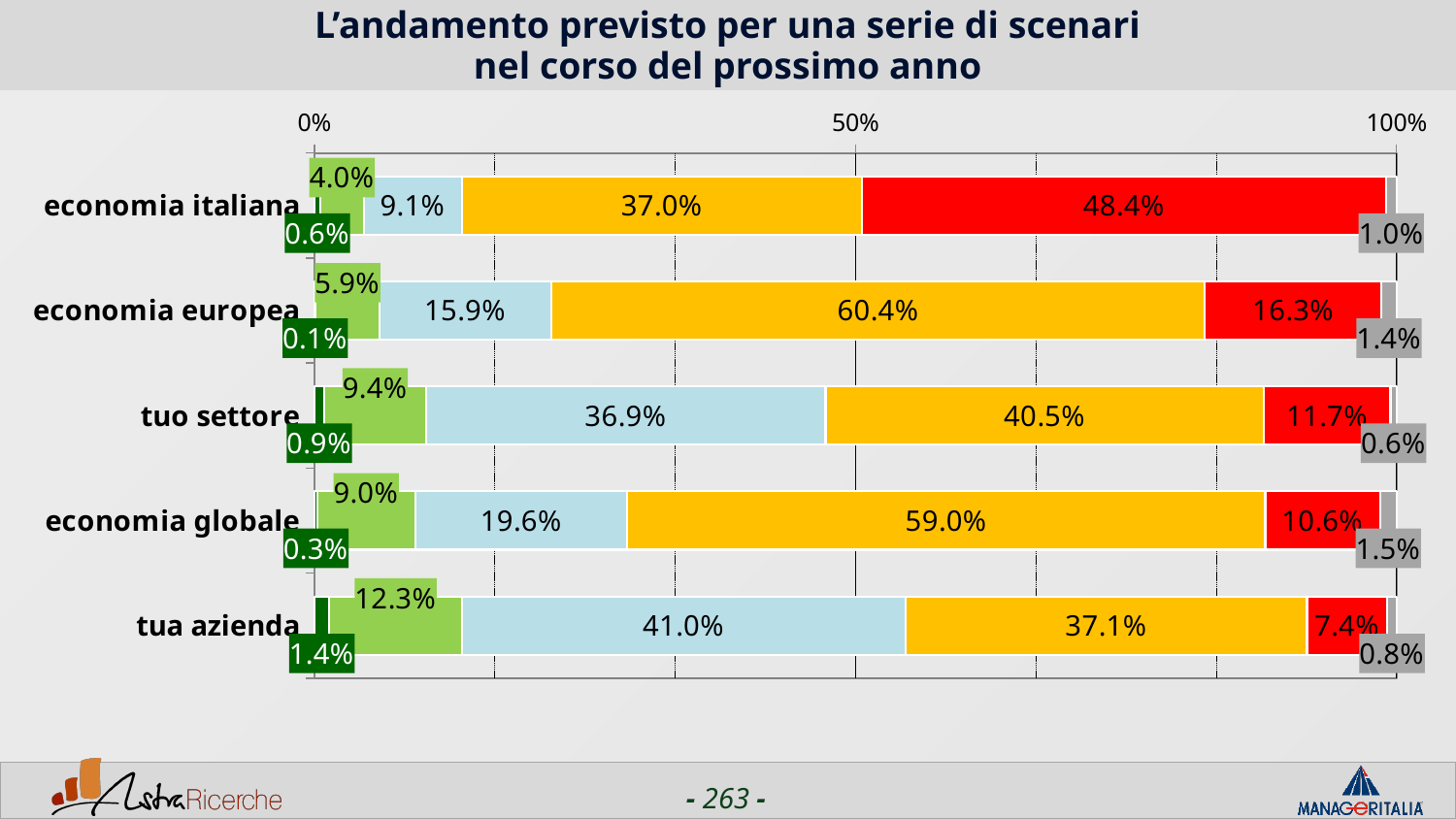
What is the value of the gray segment for 'economia globale'? 1.5% What is the difference between the yellow segment for 'economia europea' and the yellow segment for 'economia globale'? 1.4% Which category has the largest light green segment? tua azienda Which category has the largest red segment? economia italiana What is the value of the light blue segment for 'tuo settore'? 36.9% What kind of chart is shown on the slide? bar chart Which has a larger light blue segment, 'tua azienda' or 'tuo settore'? tua azienda What is the title of the chart? L'andamento previsto per una serie di scenari nel corso del prossimo anno Which category has the smallest red segment? tua azienda How many categories (scenarios) are shown on the chart? 5 What is the value of the yellow segment for 'economia europea'? 60.4% What is the value of the red segment for 'economia italiana'? 48.4%